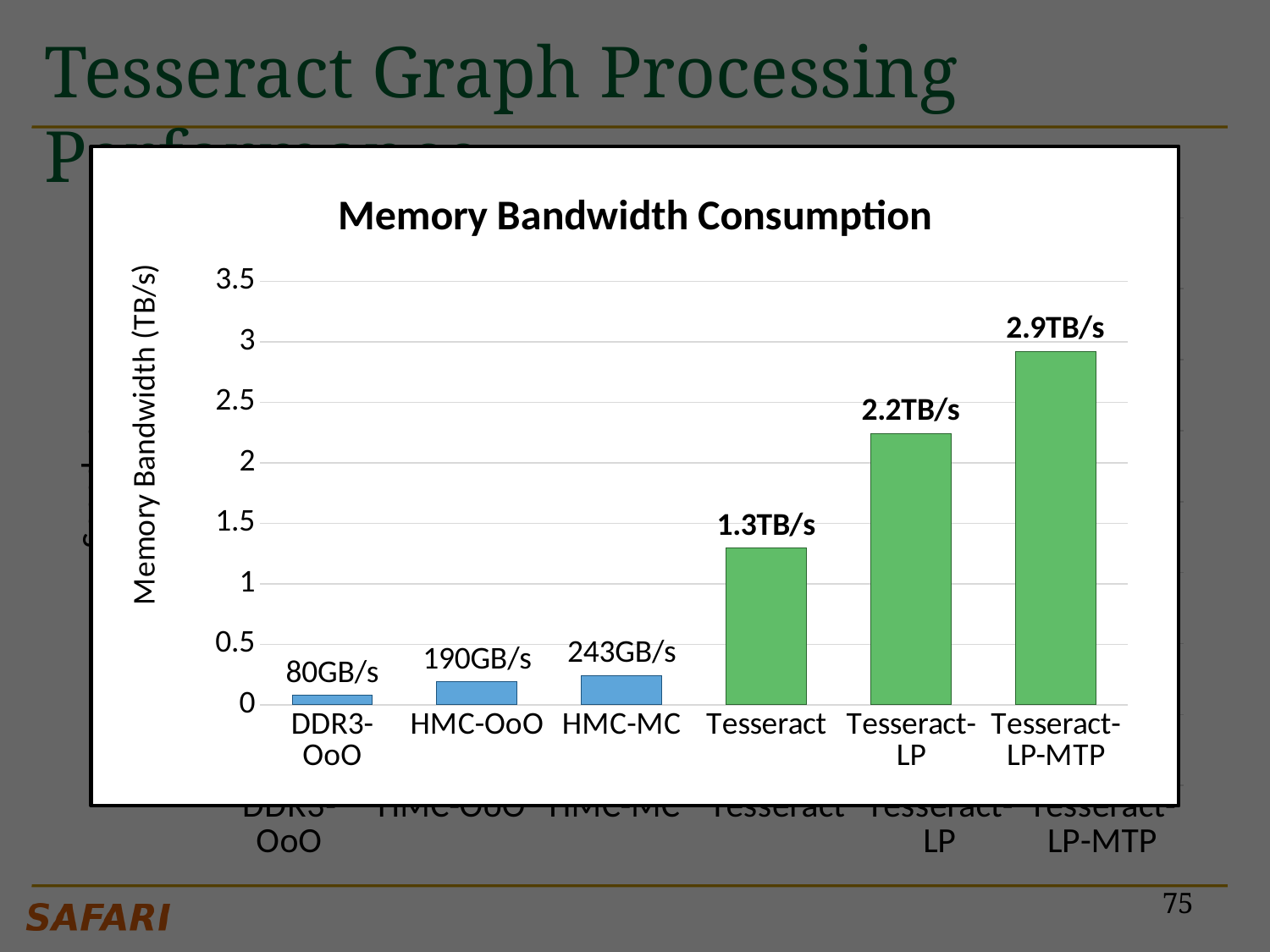
What is the memory bandwidth consumption for DDR3-OoO? 80GB/s What is the memory bandwidth consumption for Tesseract-LP? 2.2TB/s Which configuration has the highest memory bandwidth consumption? Tesseract-LP-MTP How many configurations are shown on the x axis of the chart? 6 Which has higher memory bandwidth consumption, HMC-OoO or Tesseract? Tesseract What kind of chart is used to show Memory Bandwidth Consumption? Bar chart What is the memory bandwidth consumption for Tesseract-LP-MTP? 2.9TB/s What is the label of the vertical axis of the chart? Memory Bandwidth (TB/s) What is the difference in memory bandwidth consumption between HMC-MC and HMC-OoO? 53GB/s Which configuration has the lowest memory bandwidth consumption? DDR3-OoO What is the difference in memory bandwidth consumption between Tesseract-LP-MTP and Tesseract-LP? 0.7TB/s What is the memory bandwidth consumption for HMC-MC? 243GB/s